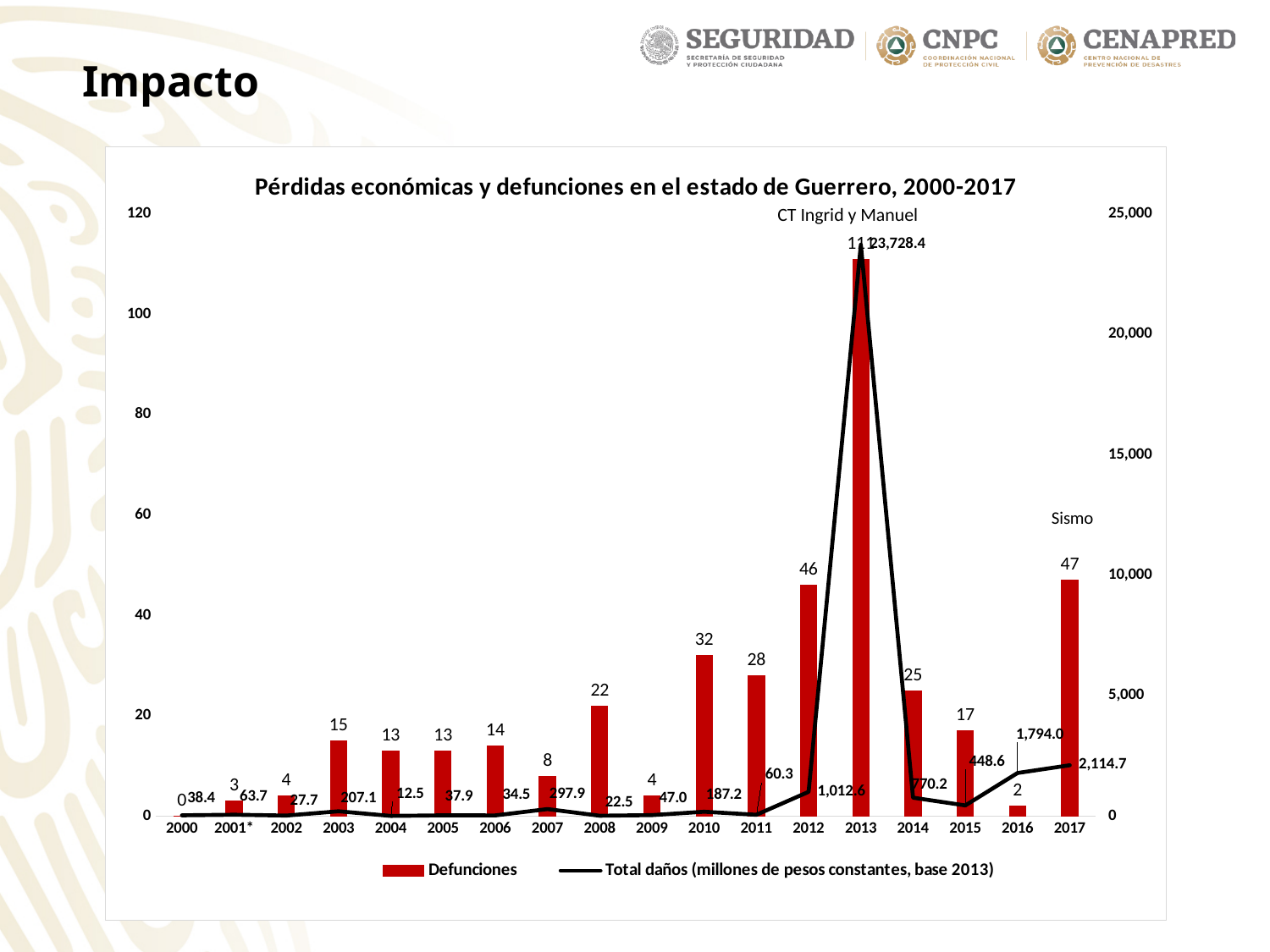
What is the value of Total daños for 2016? 1,794.0 Is the number of Defunciones for 2013 greater or less than 100? greater What is the value of Total daños for 2017? 2,114.7 How many deaths (Defunciones) are shown for 2012? 46 What is the difference in Defunciones between 2017 and 2012? 1 How many years are shown on the x axis? 18 What annotation is written above the 2013 peak of the chart? CT Ingrid y Manuel Which year has more Defunciones, 2010 or 2011? 2010 In which year is Total daños highest? 2013 In which year is the number of Defunciones lowest? 2000 In which year is Total daños lowest? 2004 How many series does the legend list? 2